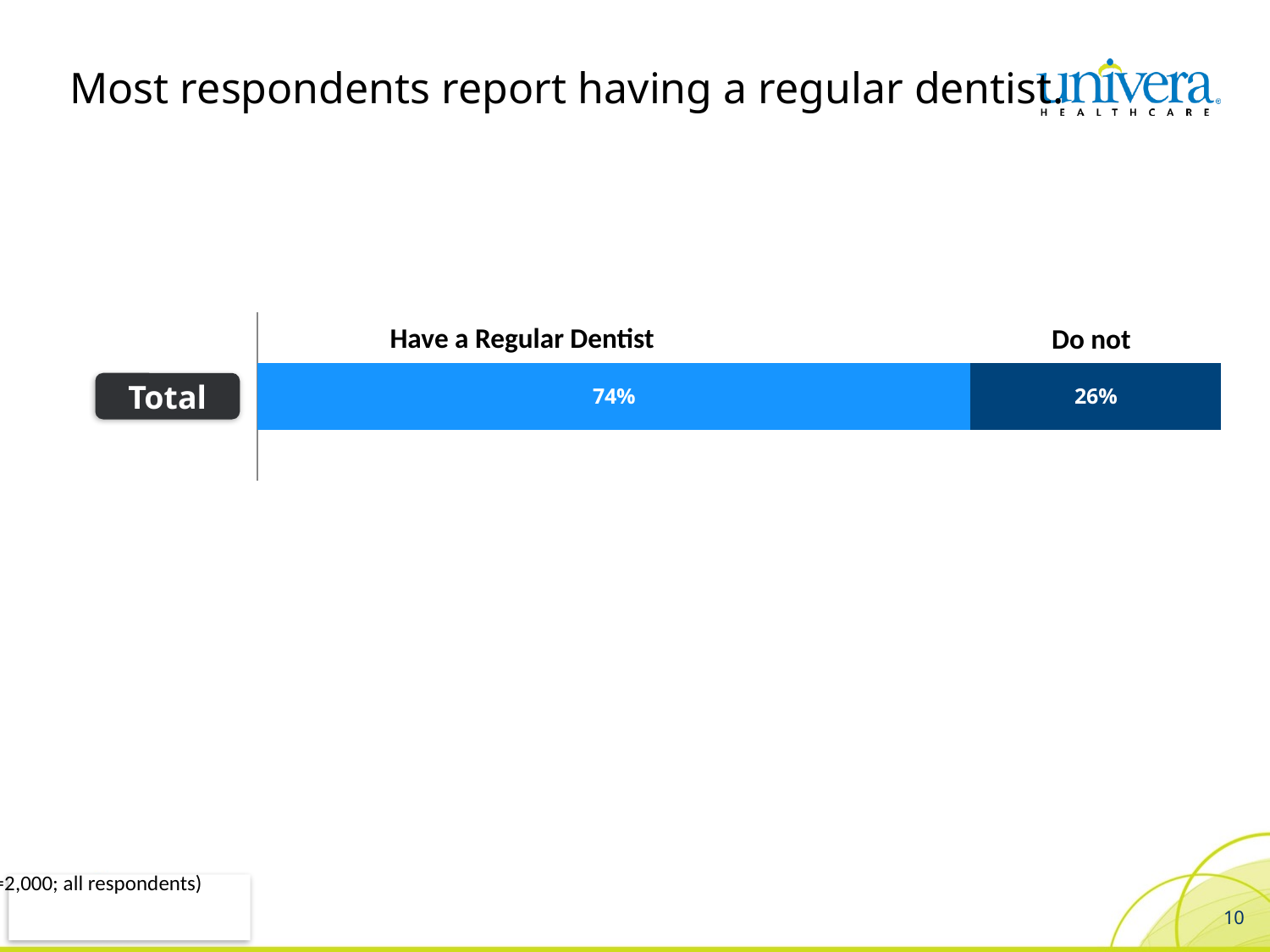
What is the label of the single row shown in the chart? Total Which segment of the Total bar is larger, 'Have a Regular Dentist' or 'Do not'? Have a Regular Dentist What percentage of respondents in the Total bar have a regular dentist? 74% What kind of chart is shown on the slide? Stacked bar chart What percentage of respondents in the Total bar do not have a regular dentist? 26% How many series are labelled above the bar? 2 Which segment has the smallest value in the Total bar? Do not How many segments make up the Total bar? 2 What is the difference in percentage points between the 'Have a Regular Dentist' and 'Do not' segments? 48 What is the total of the two segments in the Total bar? 100% Which segment has the largest value in the Total bar? Have a Regular Dentist What is the title of the slide? Most respondents report having a regular dentist.